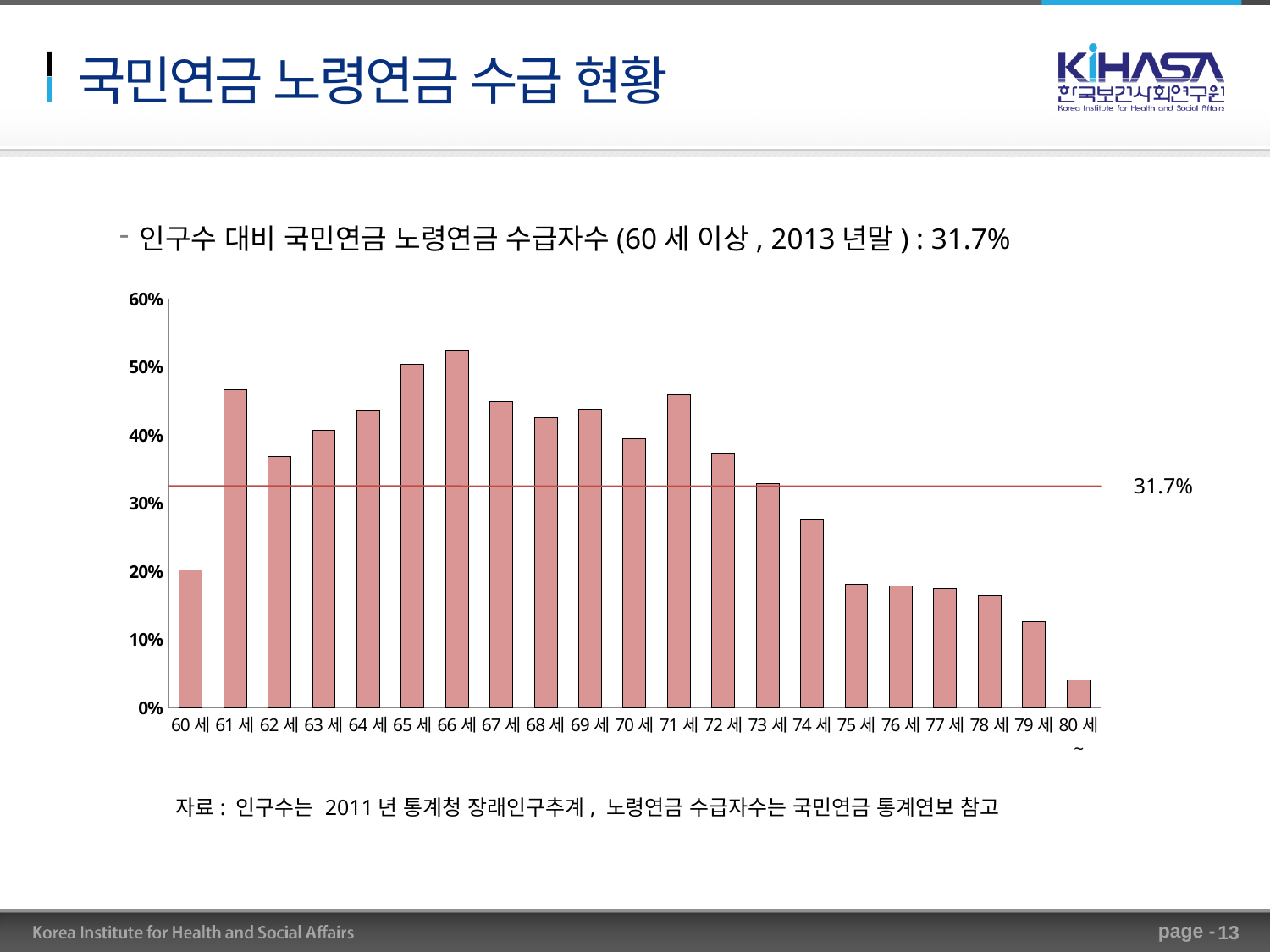
Is the value for 61 세 greater or less than 40%? greater Is the value for 74 세 greater or less than 30%? less Do the bar values rise or fall from 73 세 to 80 세~? fall Which age category has the highest bar in the chart? 66 세 Is the value for 60 세 greater or less than 30%? less Which has the larger value, 61 세 or 62 세? 61 세 What kind of chart is shown on the slide? bar chart Which has the larger value, 75 세 or 79 세? 75 세 How many age categories are shown on the x axis of the chart? 21 What value is marked by the horizontal red reference line on the chart? 31.7% Which age category has the lowest bar in the chart? 80 세~